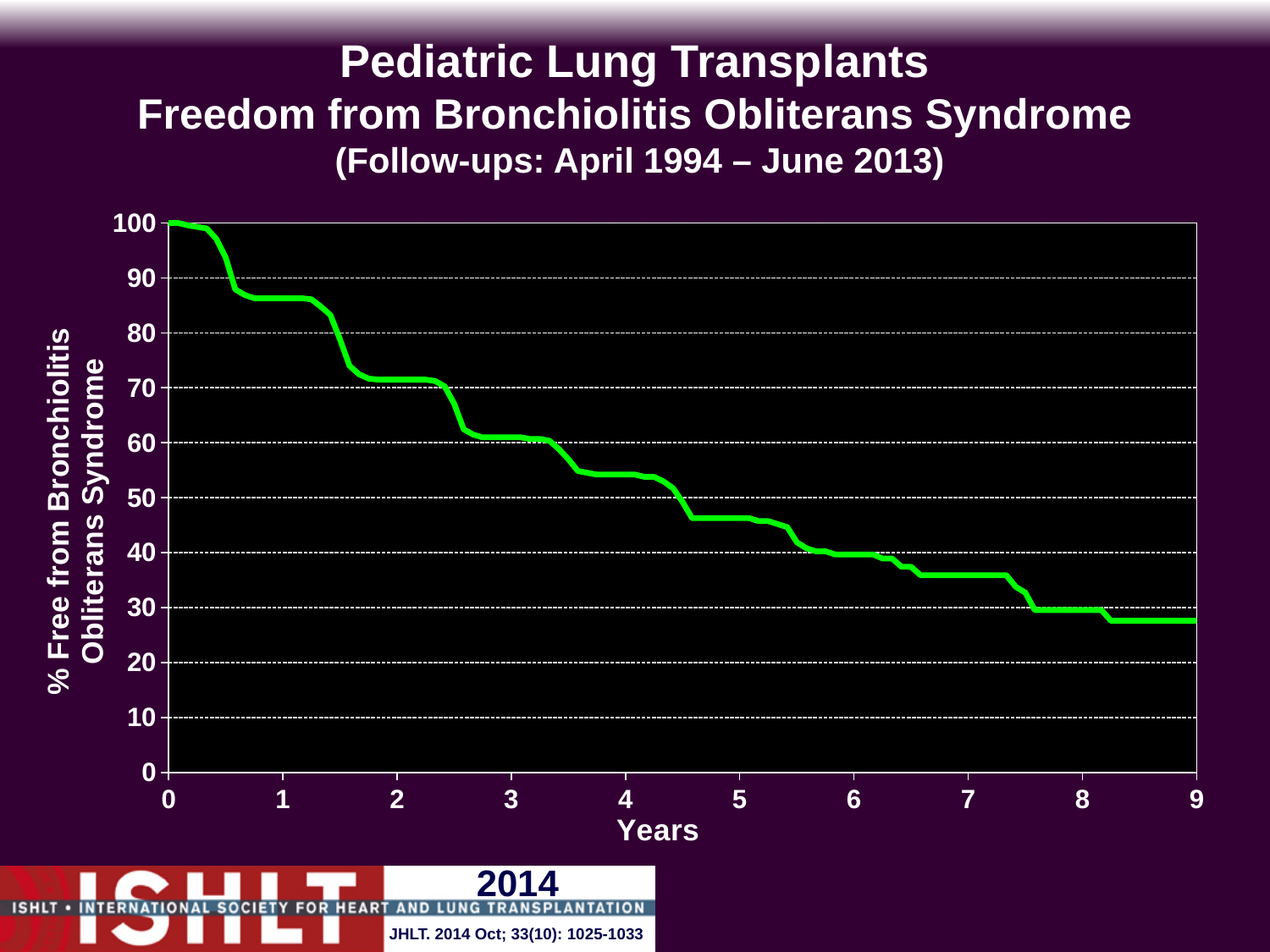
Is the value at 2 years greater or less than 80? less Is the value at 3 years greater or less than 70? less What kind of chart is shown on the slide? line chart Is the value at 1 year greater or less than 80? greater Does the percentage free from bronchiolitis obliterans syndrome rise or fall as the years increase? fall What is the value of the curve at 0 years? 100 What follow-up period is given in the chart title? April 1994 – June 2013 What is the label of the x axis? Years